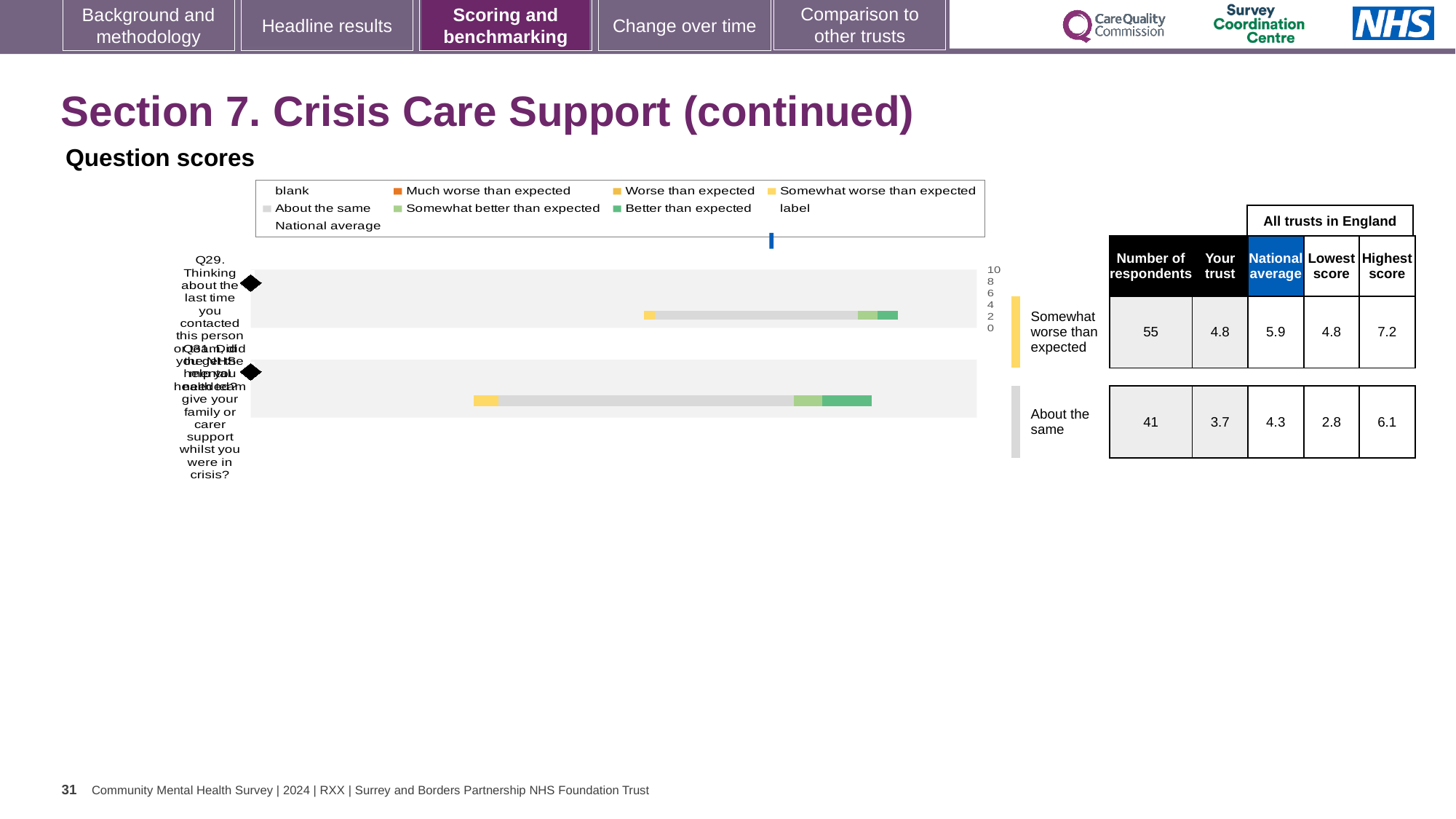
What is the 'Your trust' score for Q29 shown in the table? 4.8 Which question has the higher 'Your trust' score, Q29 or Q31? Q29 What is the difference between the highest and lowest scores for Q31? 3.3 What is the national average for Q31 shown in the table? 4.3 What benchmark category is the trust's Q31 score placed in? About the same How many questions are plotted in the chart? 2 Which question has more respondents, Q29 or Q31? Q29 What is the difference between the national average and the trust score for Q29? 1.1 What is the highest score across all trusts in England for Q31? 6.1 What kind of chart is used to show the question scores? Bar chart How many respondents answered Q29? 55 What is the lowest score across all trusts in England for Q29? 4.8